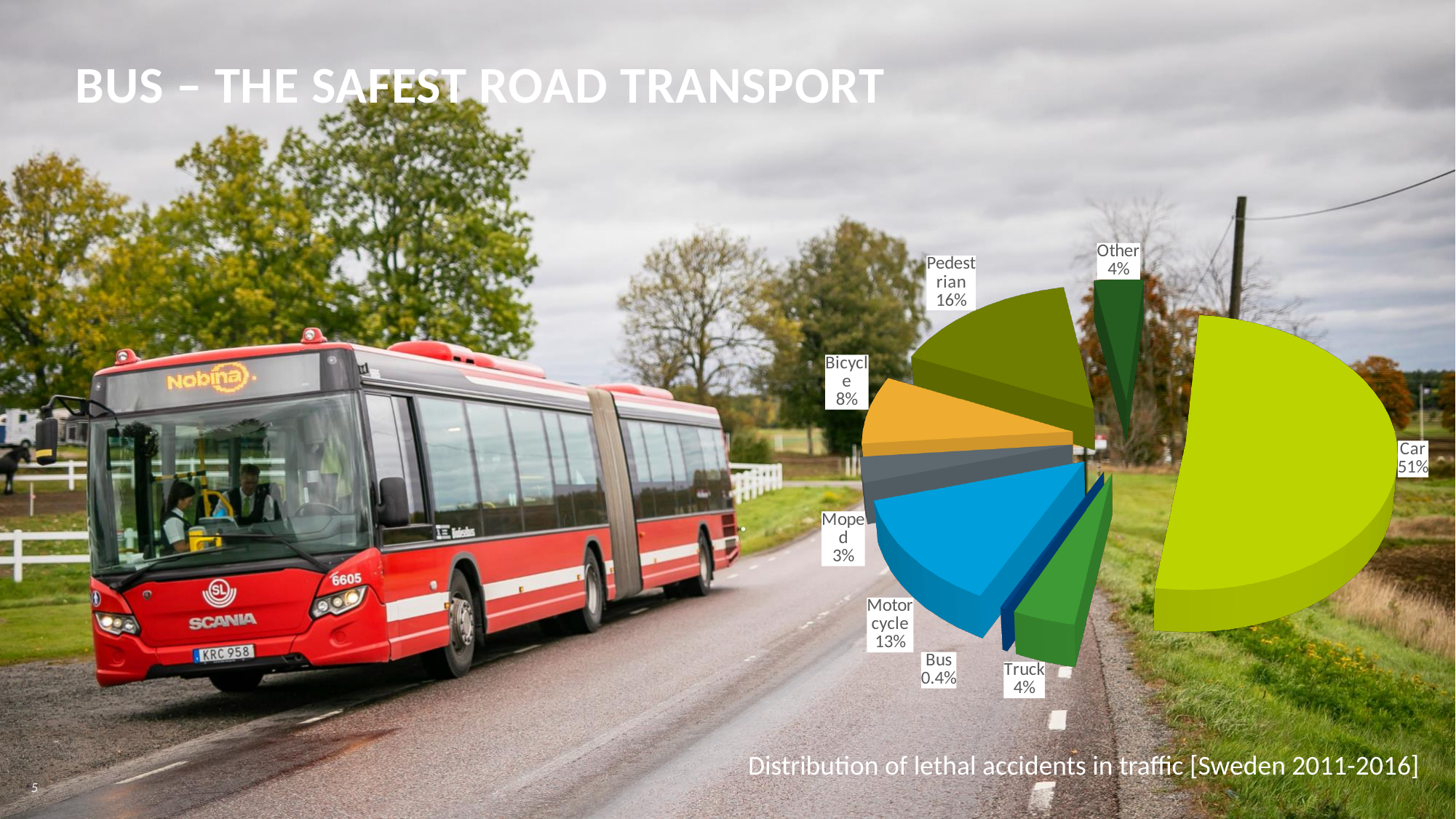
Which category has the largest share of lethal traffic accidents? Car Which has a larger share of lethal traffic accidents, Bicycle or Motorcycle? Motorcycle What share of lethal traffic accidents is attributed to Pedestrian? 16% How many categories are shown in the pie chart? 8 What does the caption below the chart say the chart shows? Distribution of lethal accidents in traffic [Sweden 2011-2016] What share of lethal traffic accidents is attributed to Car? 51% What share of lethal traffic accidents is attributed to Bus? 0.4% What kind of chart is shown on the slide? Pie chart Which category has the smallest share of lethal traffic accidents? Bus What share of lethal traffic accidents is attributed to Moped? 3% What share of lethal traffic accidents is attributed to Motorcycle? 13% What is the difference in percentage points between the Car share and the Pedestrian share? 35